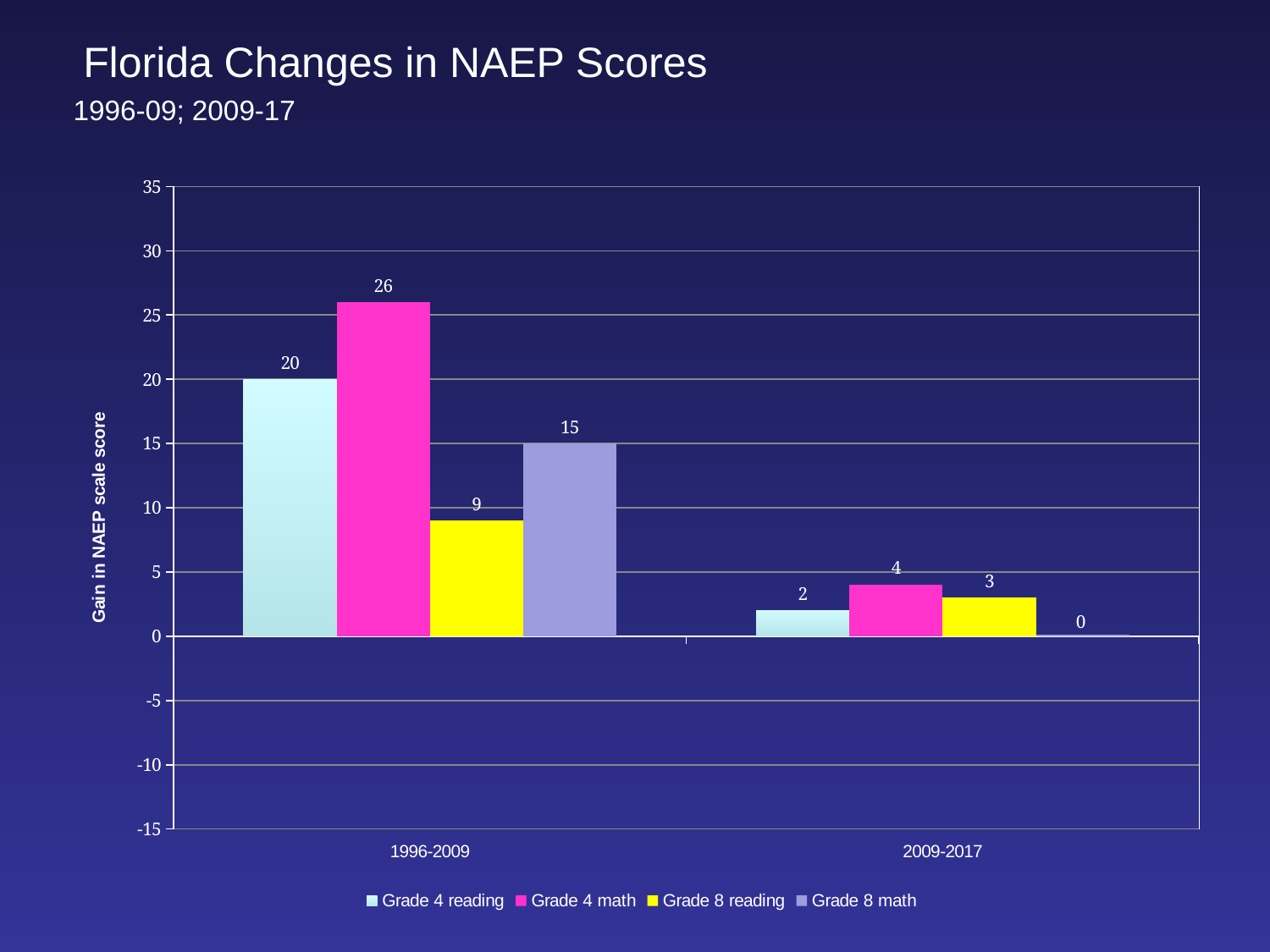
Which is larger: the Grade 8 math gain in 1996-2009 or the Grade 4 reading gain in 1996-2009? Grade 4 reading gain in 1996-2009 What is the label of the vertical axis? Gain in NAEP scale score What is the gain in NAEP scale score for Grade 8 reading in 2009-2017? 3 Which series has the lowest gain in the 1996-2009 period? Grade 8 reading How many series does the legend list? 4 What is the difference between the Grade 4 reading gain in 1996-2009 and in 2009-2017? 18 What is the gain in NAEP scale score for Grade 8 math in 2009-2017? 0 How many periods are shown on the x axis? 2 Which series has the highest gain in the 1996-2009 period? Grade 4 math Do the Grade 4 math gains rise or fall from 1996-2009 to 2009-2017? Fall What is the gain in NAEP scale score for Grade 4 math in 1996-2009? 26 What kind of chart is shown on the slide? Bar chart